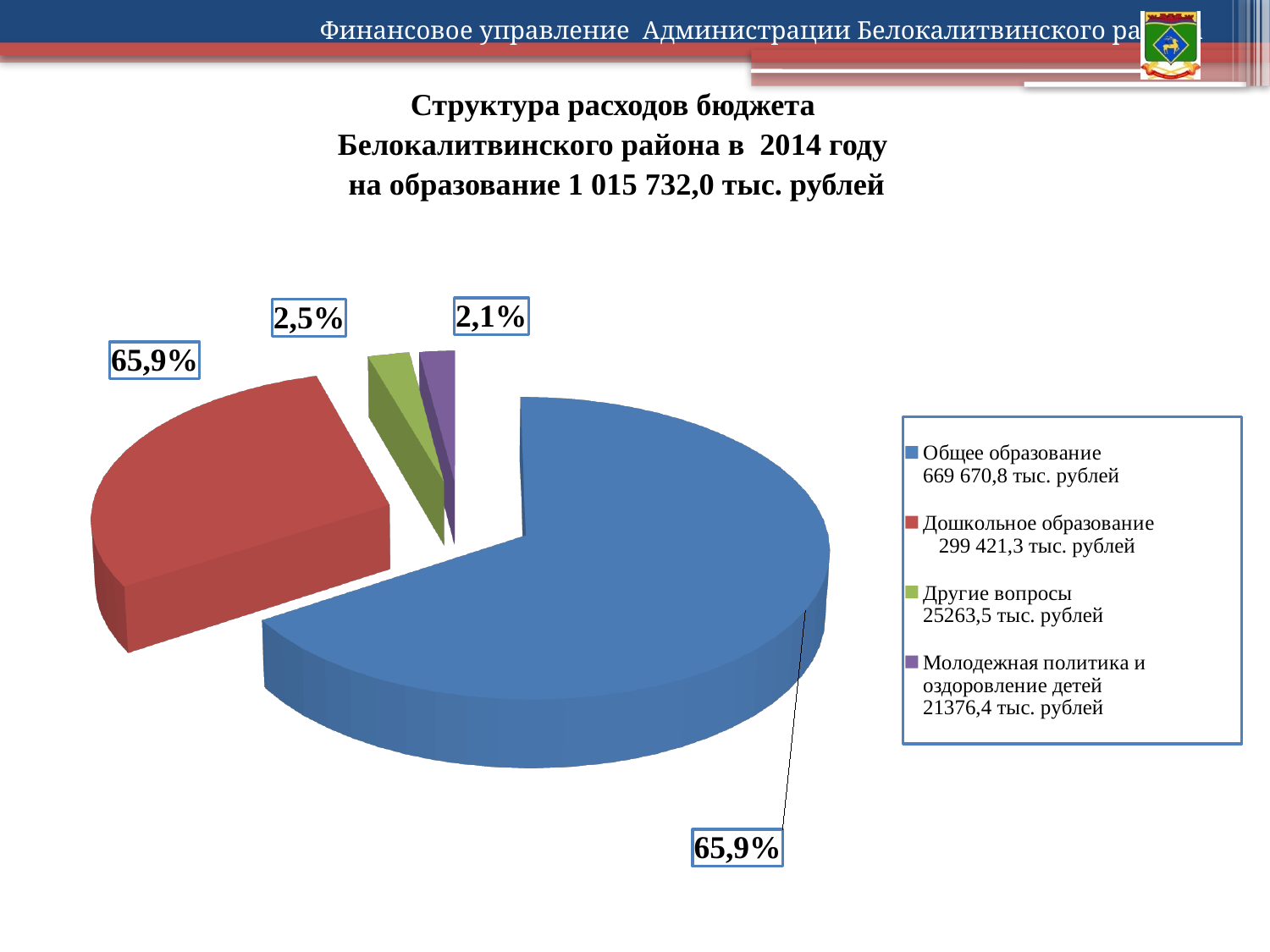
What share of the pie does Общее образование take? 65,9% What kind of chart is shown on the slide? pie chart Which category has the smallest share of the pie? Молодежная политика и оздоровление детей How many slices does the pie chart have? 4 Which category has the largest share of the pie? Общее образование What share of the pie does Молодежная политика и оздоровление детей take? 2,1% According to the legend, what is the value for Общее образование? 669 670,8 тыс. рублей Which is larger, Дошкольное образование or Другие вопросы? Дошкольное образование What is the total education expenditure stated in the chart title? 1 015 732,0 тыс. рублей According to the legend, what is the value for Дошкольное образование? 299 421,3 тыс. рублей According to the legend, what is the value for Молодежная политика и оздоровление детей? 21376,4 тыс. рублей According to the legend, what is the value for Другие вопросы? 25263,5 тыс. рублей